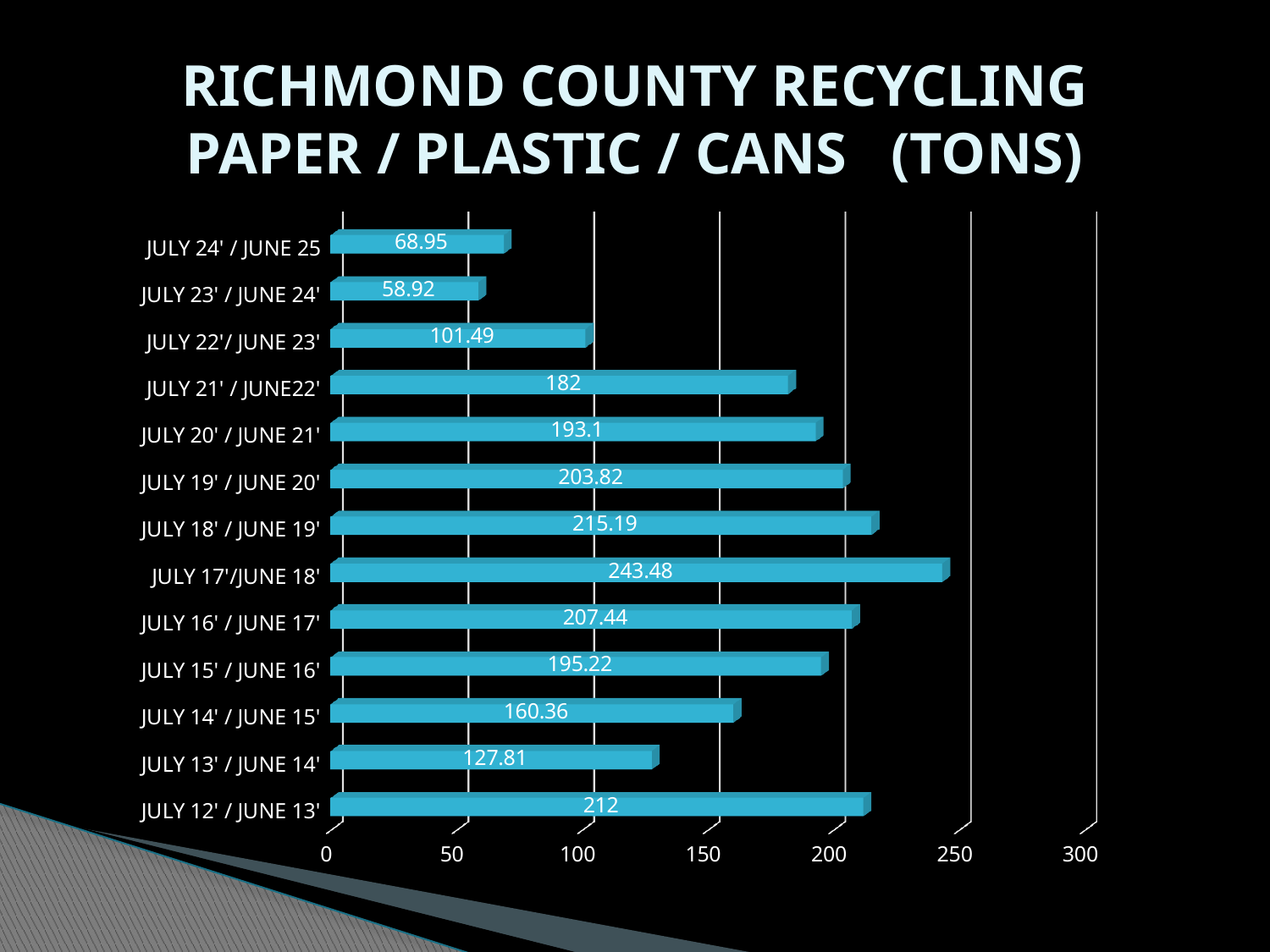
What is the value for JULY 23' / JUNE 24'? 58.92 What is the value for JULY 12' / JUNE 13'? 212 How many categories are shown on the chart? 13 What is the title of the chart? RICHMOND COUNTY RECYCLING PAPER / PLASTIC / CANS (TONS) What is the difference between the values for JULY 18' / JUNE 19' and JULY 19' / JUNE 20'? 11.37 Is the value for JULY 22'/ JUNE 23' greater or less than 150? less Which is larger, the value for JULY 14' / JUNE 15' or the value for JULY 13' / JUNE 14'? JULY 14' / JUNE 15' What kind of chart is shown on the slide? bar chart Which category has the highest value? JULY 17'/JUNE 18' What is the value for JULY 17'/JUNE 18'? 243.48 What is the difference between the values for JULY 24' / JUNE 25 and JULY 23' / JUNE 24'? 10.03 Which category has the lowest value? JULY 23' / JUNE 24'